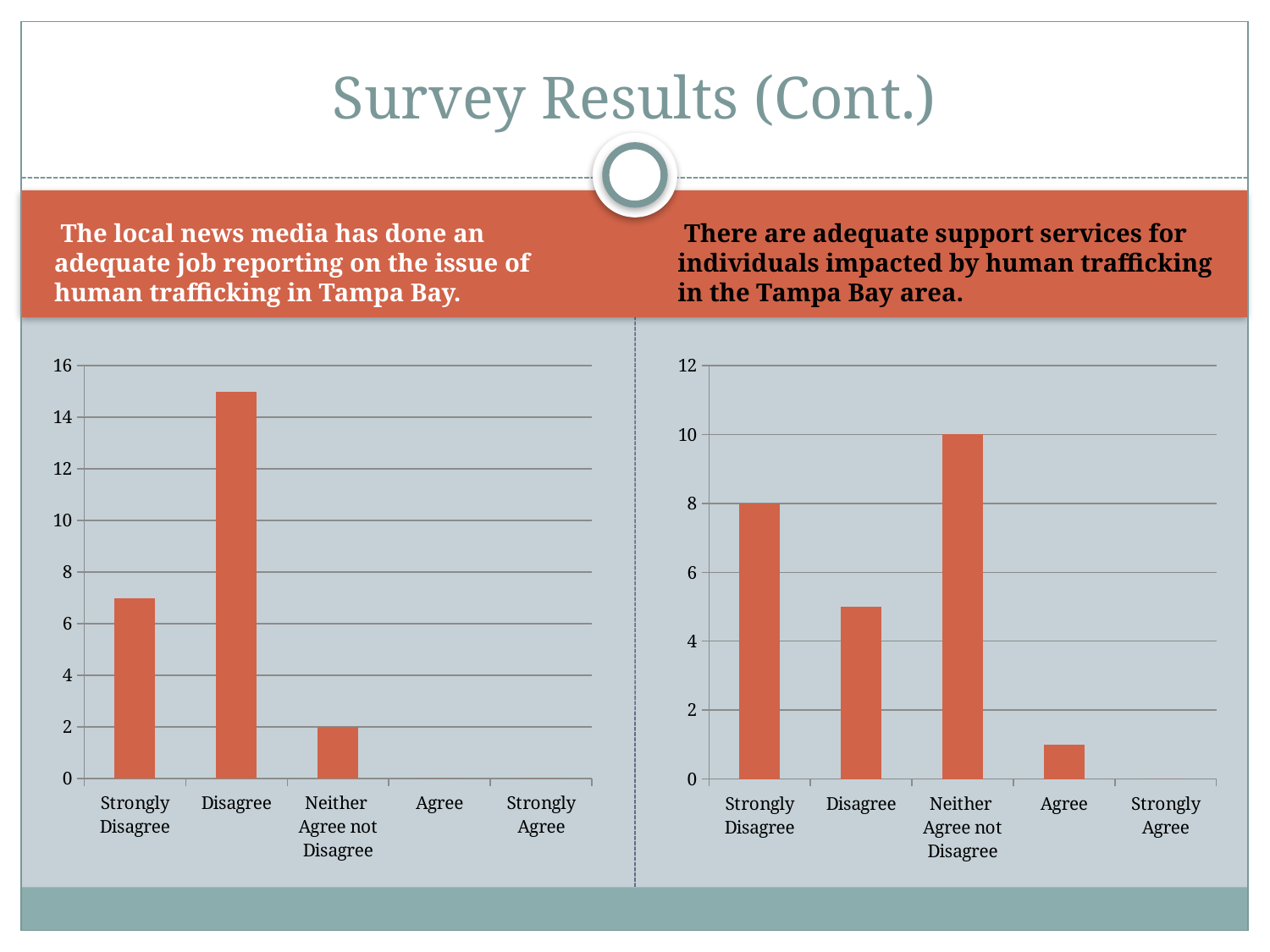
On the right chart (adequate support services), what is the value for Strongly Disagree? 8 On the left chart (local news media), is the value for Strongly Disagree greater or less than 8? less On the left chart (local news media), is the value for Disagree greater or less than 14? greater What kind of chart is the right chart (adequate support services)? bar chart On the right chart (adequate support services), which is larger, the value for Strongly Disagree or the value for Disagree? Strongly Disagree On the left chart (local news media), which category has the highest value? Disagree How many categories are shown on the x axis of the left chart (local news media)? 5 On the left chart (local news media), what is the value for Neither Agree not Disagree? 2 On the right chart (adequate support services), is the value for Disagree greater or less than 6? less On the right chart (adequate support services), which category has the highest value? Neither Agree not Disagree On the right chart (adequate support services), what is the difference between the values for Neither Agree not Disagree and Strongly Disagree? 2 On the right chart (adequate support services), what is the value for Neither Agree not Disagree? 10